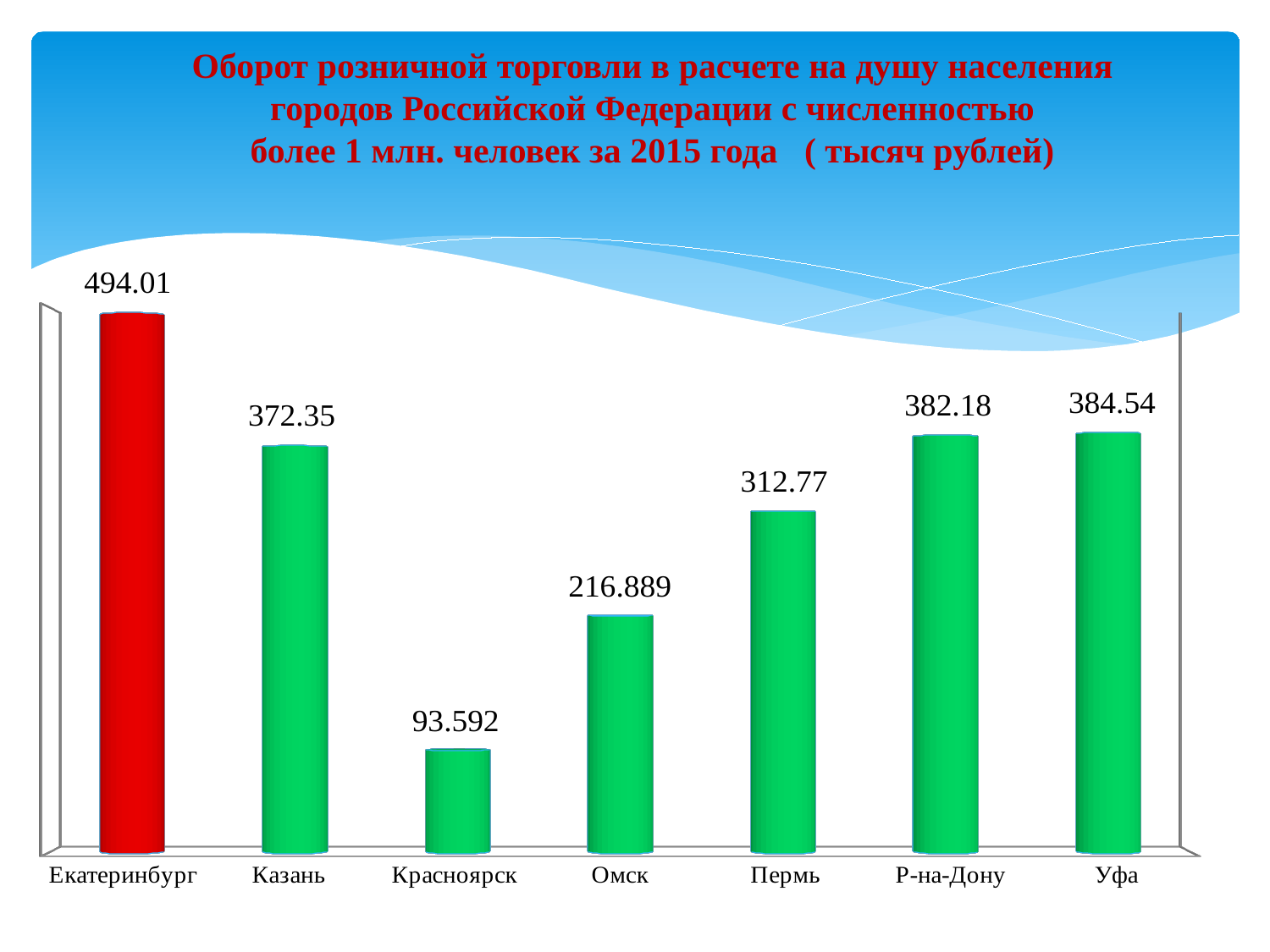
What is the difference between the values for Екатеринбург and Казань? 121.66 Which has a larger value, Казань or Пермь? Казань Which city has the lowest value? Красноярск What kind of chart is shown on the slide? Bar chart What is the value for Екатеринбург? 494.01 What is the value for Омск? 216.889 How many cities are shown in the chart? 7 Which city has the highest value? Екатеринбург What is the difference between the values for Пермь and Омск? 95.881 What is the value for Красноярск? 93.592 Which has a larger value, Уфа or Р-на-Дону? Уфа What is the value for Р-на-Дону? 382.18